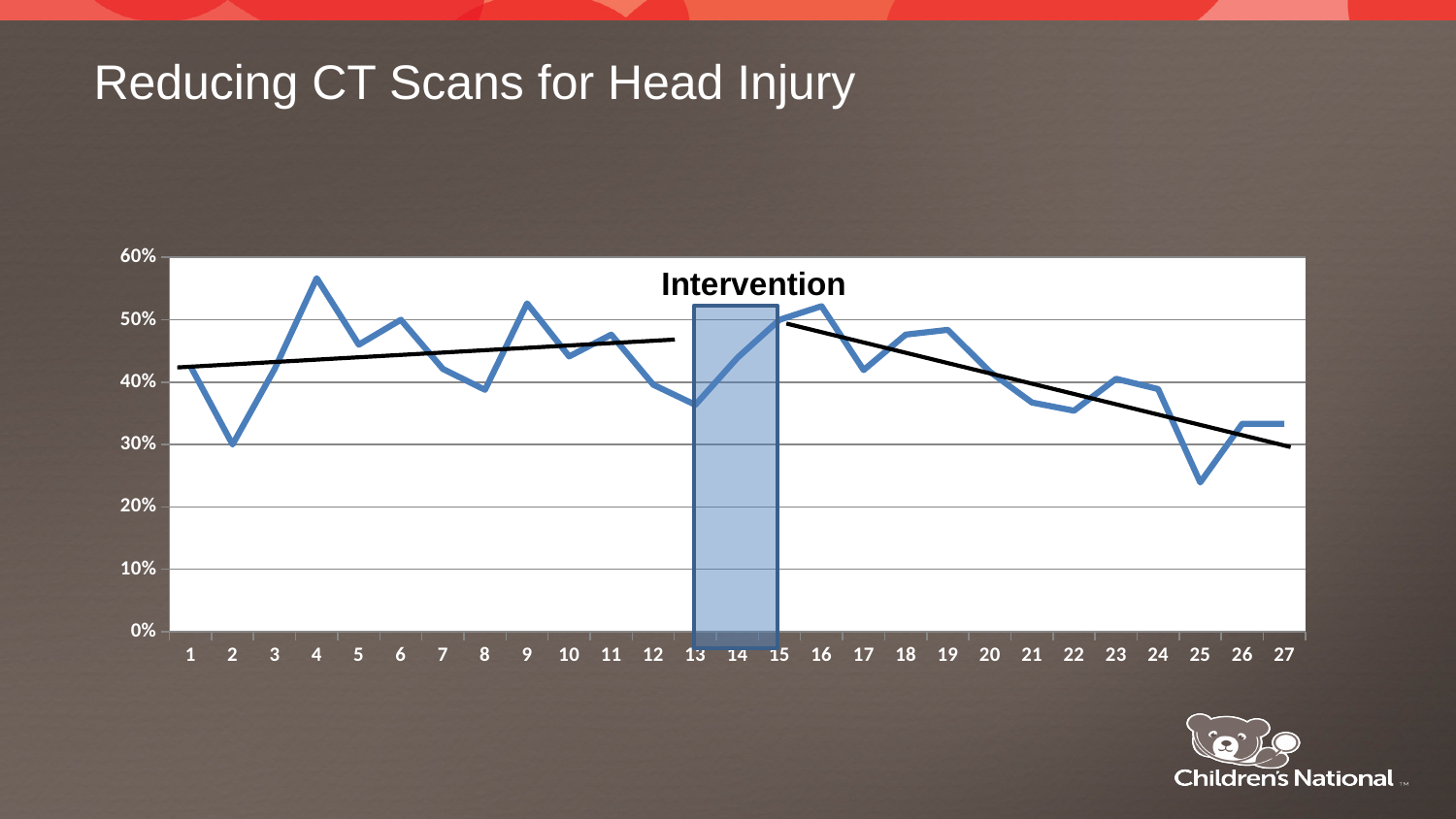
Which is larger, the value at point 4 or the value at point 25? point 4 What label is shown above the shaded region of the chart? Intervention Is the value at point 16 greater or less than 50%? greater At which x-axis point does the line reach its highest value? 4 At which x-axis point does the line reach its lowest value? 25 Is the value at point 25 greater or less than 30%? less Is the value at point 4 greater or less than 50%? greater What kind of chart is shown on the slide? line chart How many points are plotted along the x axis? 27 Do the values generally rise or fall from point 15 to point 27? fall Which is larger, the value at point 16 or the value at point 13? point 16